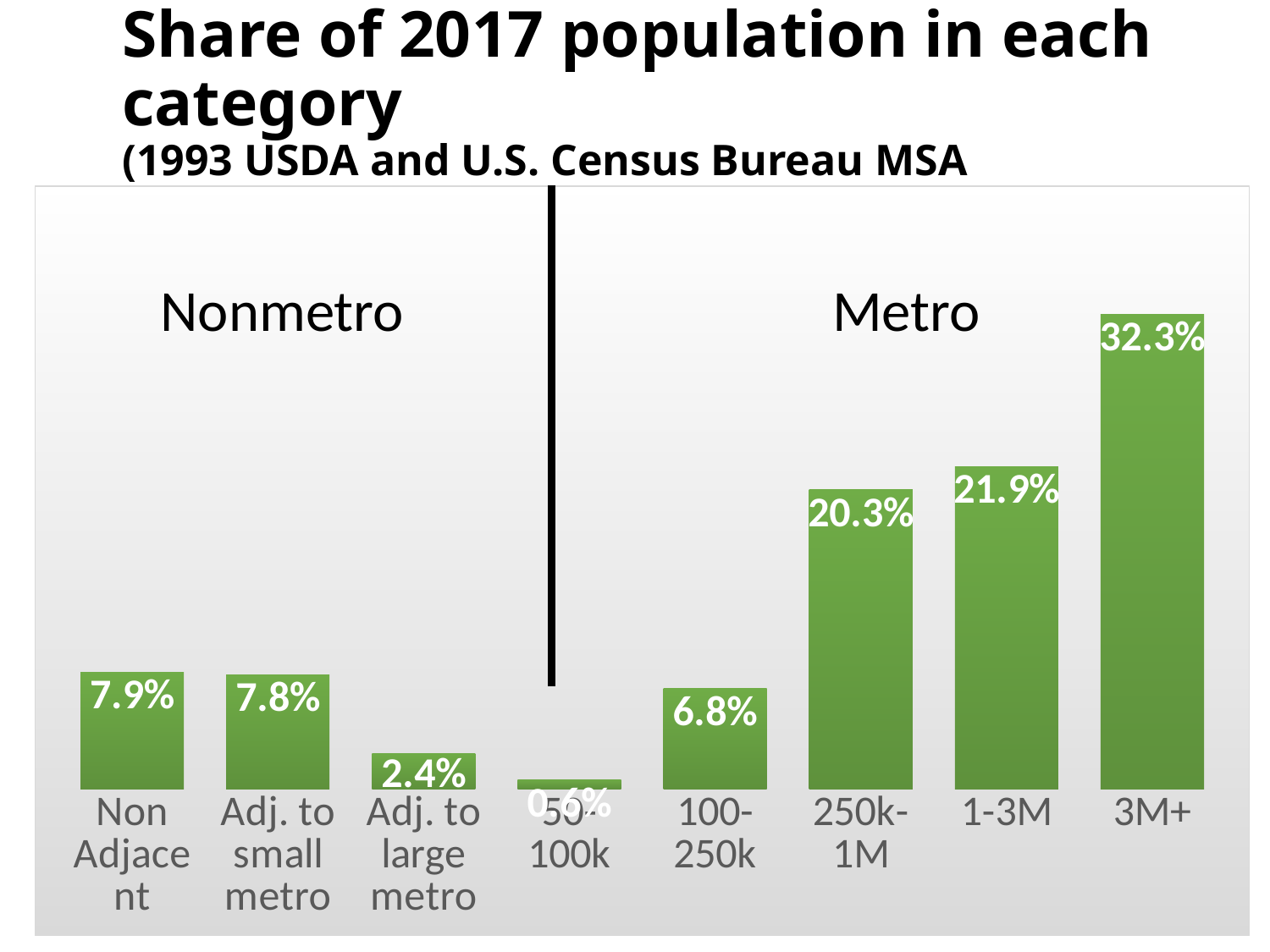
What is the value for the 100-250k category? 6.8% What is the value for the 250k-1M category? 20.3% Which category has the highest share of 2017 population? 3M+ How many categories are shown in the chart? 8 What is the value for the Non Adjacent category? 7.9% What is the difference between the values for 3M+ and 1-3M? 10.4% Which is larger, the value for Non Adjacent or the value for Adj. to small metro? Non Adjacent Which category has the lowest share of 2017 population? 50-100k What is the value for the 3M+ category? 32.3% What kind of chart is shown on the slide? Bar chart What is the difference between the values for 250k-1M and 100-250k? 13.5% What are the two group labels shown above the bars in the chart? Nonmetro and Metro